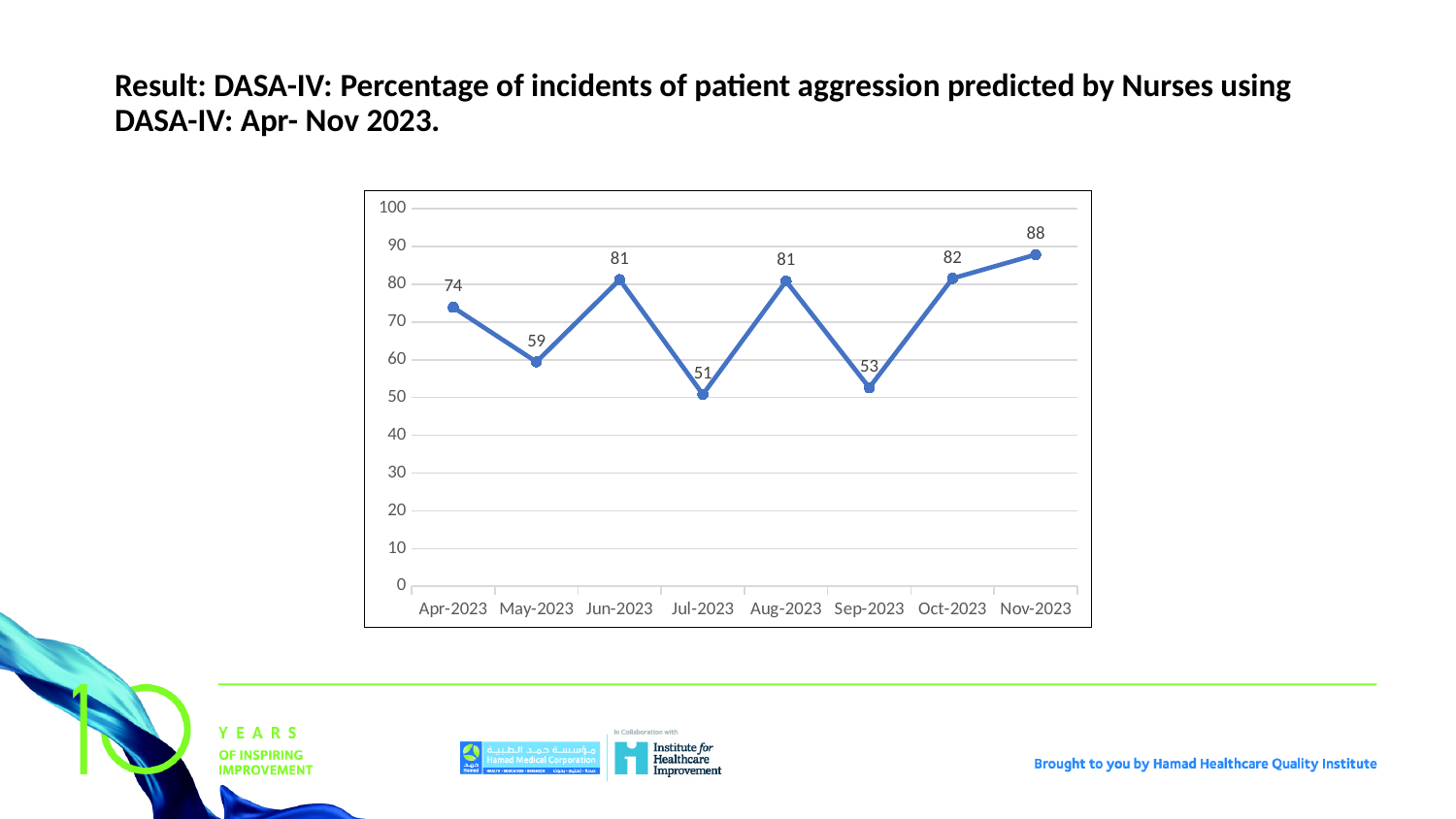
Which is larger, the value for Sep-2023 or the value for Oct-2023? Oct-2023 How many months are plotted on the chart? 8 Is the value for May-2023 greater or less than 50? greater What kind of chart is shown on the slide? line chart What is the value for Jul-2023? 51 What is the value for Apr-2023? 74 What is the difference between the values for Apr-2023 and May-2023? 15 Which month has the highest value? Nov-2023 Which month has the lowest value? Jul-2023 Does the value rise or fall from Sep-2023 to Nov-2023? rise What is the value for Nov-2023? 88 What is the difference between the values for Nov-2023 and Jul-2023? 37